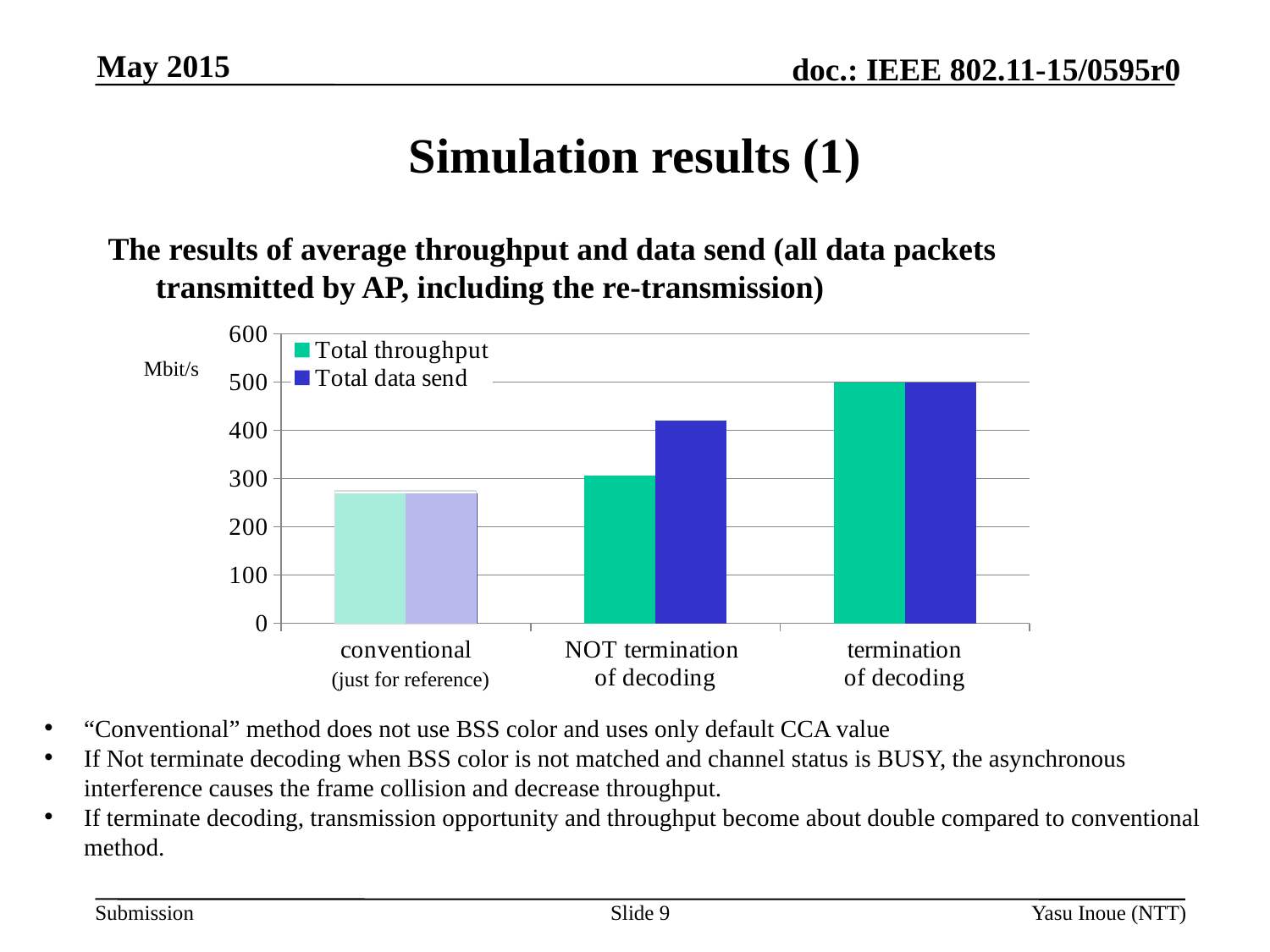
Is the Total throughput for termination of decoding greater or less than 400? greater How many series does the chart legend list? 2 Is the Total throughput for conventional greater or less than 300? less What unit is shown on the y axis of the chart? Mbit/s For NOT termination of decoding, which is larger: Total throughput or Total data send? Total data send What kind of chart is shown on the slide? bar chart Is the Total data send for NOT termination of decoding greater or less than 400? greater Which series is shown in green in the chart? Total throughput Which category has the lowest Total data send? conventional How many categories are shown along the x axis of the chart? 3 Which category has the highest Total throughput? termination of decoding